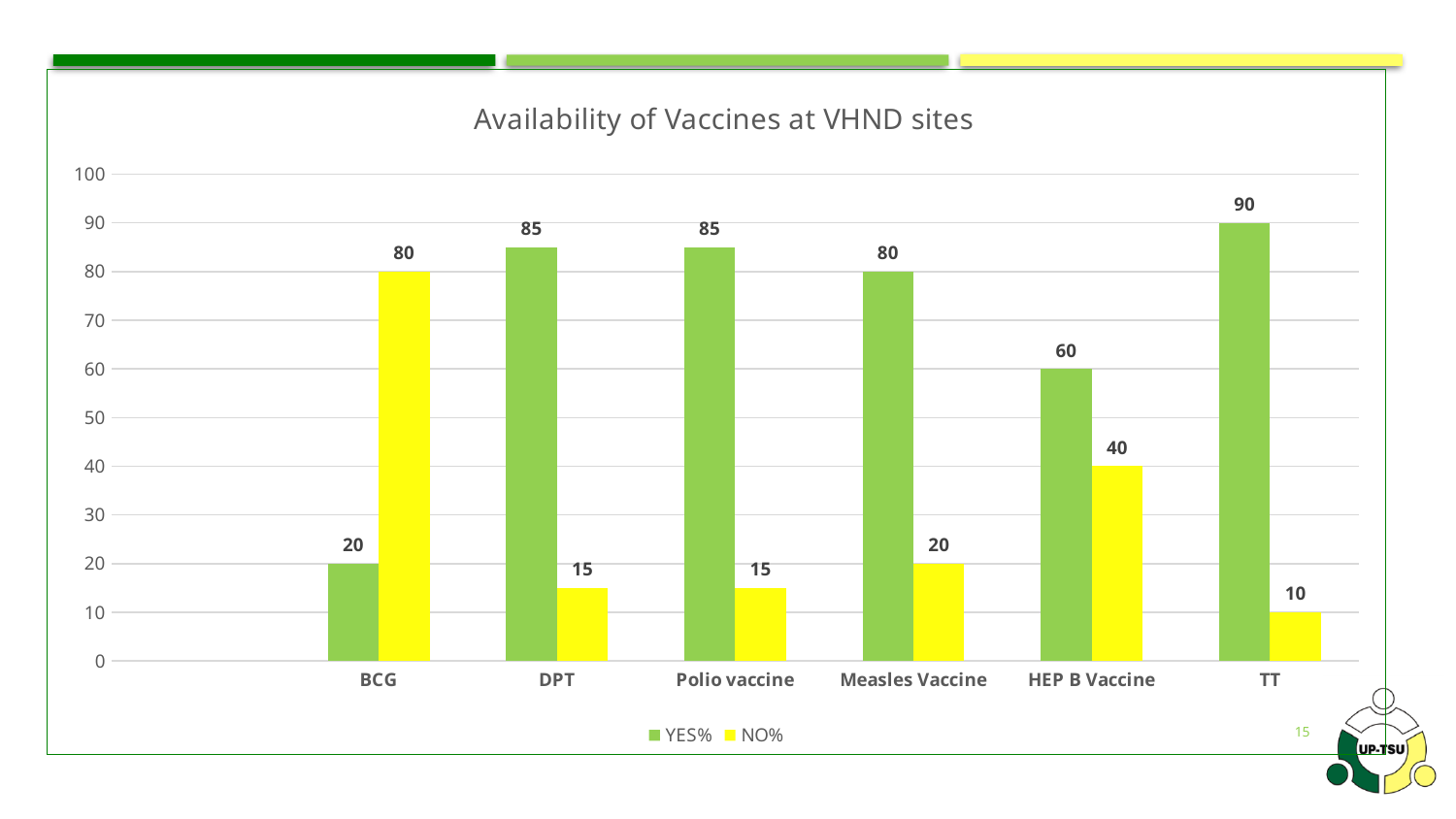
Which is larger for BCG, the YES% value or the NO% value? NO% Which vaccine has the highest YES% value? TT Which vaccine has the lowest NO% value? TT What is the difference between the YES% and NO% values for Measles Vaccine? 60 What kind of chart is shown on the slide? Bar chart What is the YES% value for BCG? 20 How many vaccine categories are shown on the x axis? 6 What is the NO% value for HEP B Vaccine? 40 What is the title of the chart? Availability of Vaccines at VHND sites What is the difference between the YES% values for DPT and HEP B Vaccine? 25 How many series does the legend list? 2 What is the YES% value for TT? 90